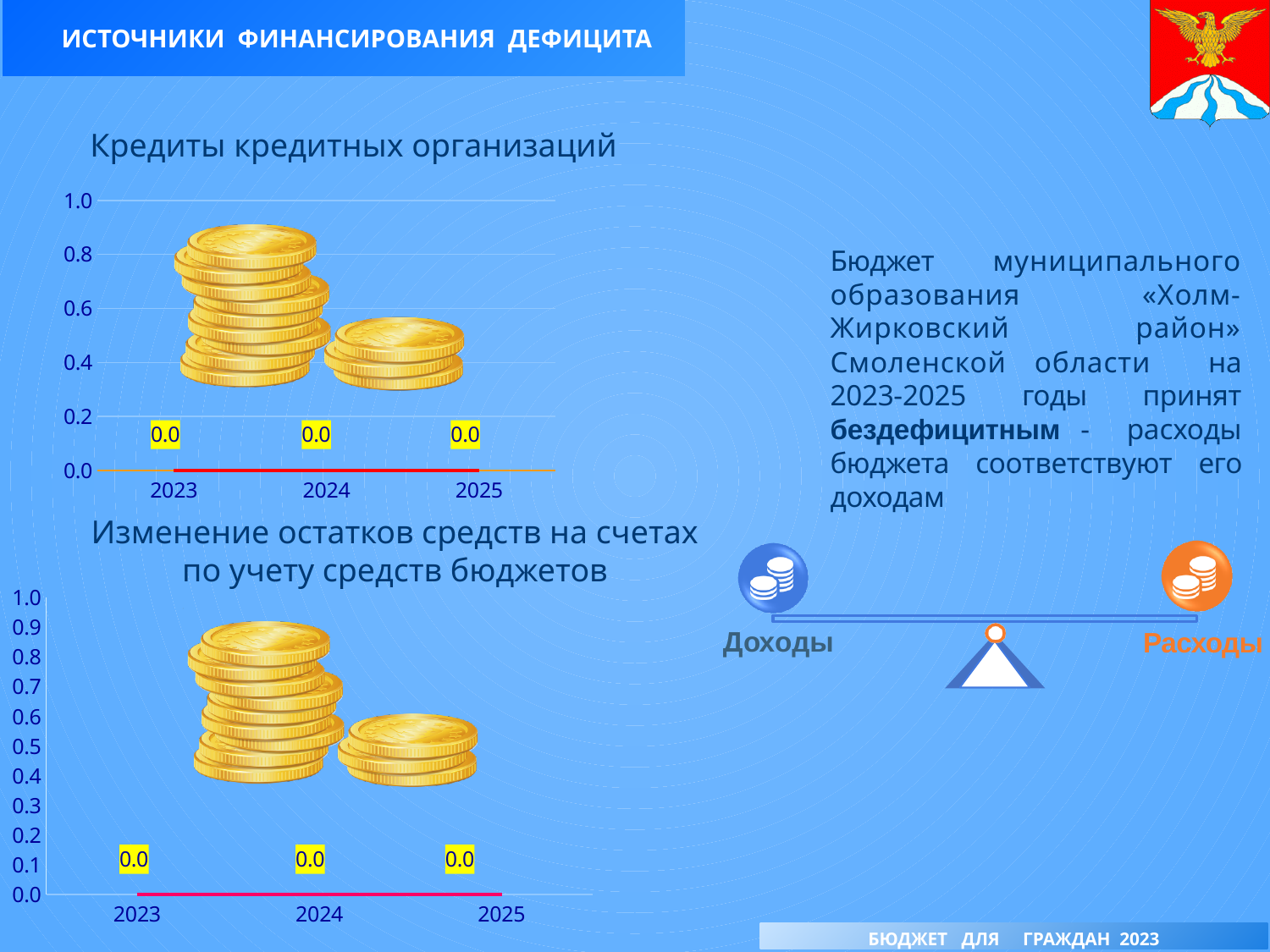
In the chart titled "Изменение остатков средств на счетах по учету средств бюджетов", what is the difference between the values for 2025 and 2023? 0.0 What is the title of the upper chart on the slide? Кредиты кредитных организаций Do the values in the chart titled "Кредиты кредитных организаций" rise, fall or stay the same from 2023 to 2025? stay the same What is the highest value shown on the vertical axis of the chart titled "Изменение остатков средств на счетах по учету средств бюджетов"? 1.0 How many years are plotted in the chart titled "Изменение остатков средств на счетах по учету средств бюджетов"? 3 In the chart titled "Кредиты кредитных организаций", what is the value for 2023? 0.0 In the chart titled "Кредиты кредитных организаций", what is the value for 2025? 0.0 In the chart titled "Изменение остатков средств на счетах по учету средств бюджетов", what is the value for 2024? 0.0 In the chart titled "Изменение остатков средств на счетах по учету средств бюджетов", what is the value for 2025? 0.0 Do the values in the chart titled "Изменение остатков средств на счетах по учету средств бюджетов" rise, fall or stay the same from 2023 to 2025? stay the same In the chart titled "Кредиты кредитных организаций", what is the difference between the values for 2024 and 2023? 0.0 How many years are plotted in the chart titled "Кредиты кредитных организаций"? 3